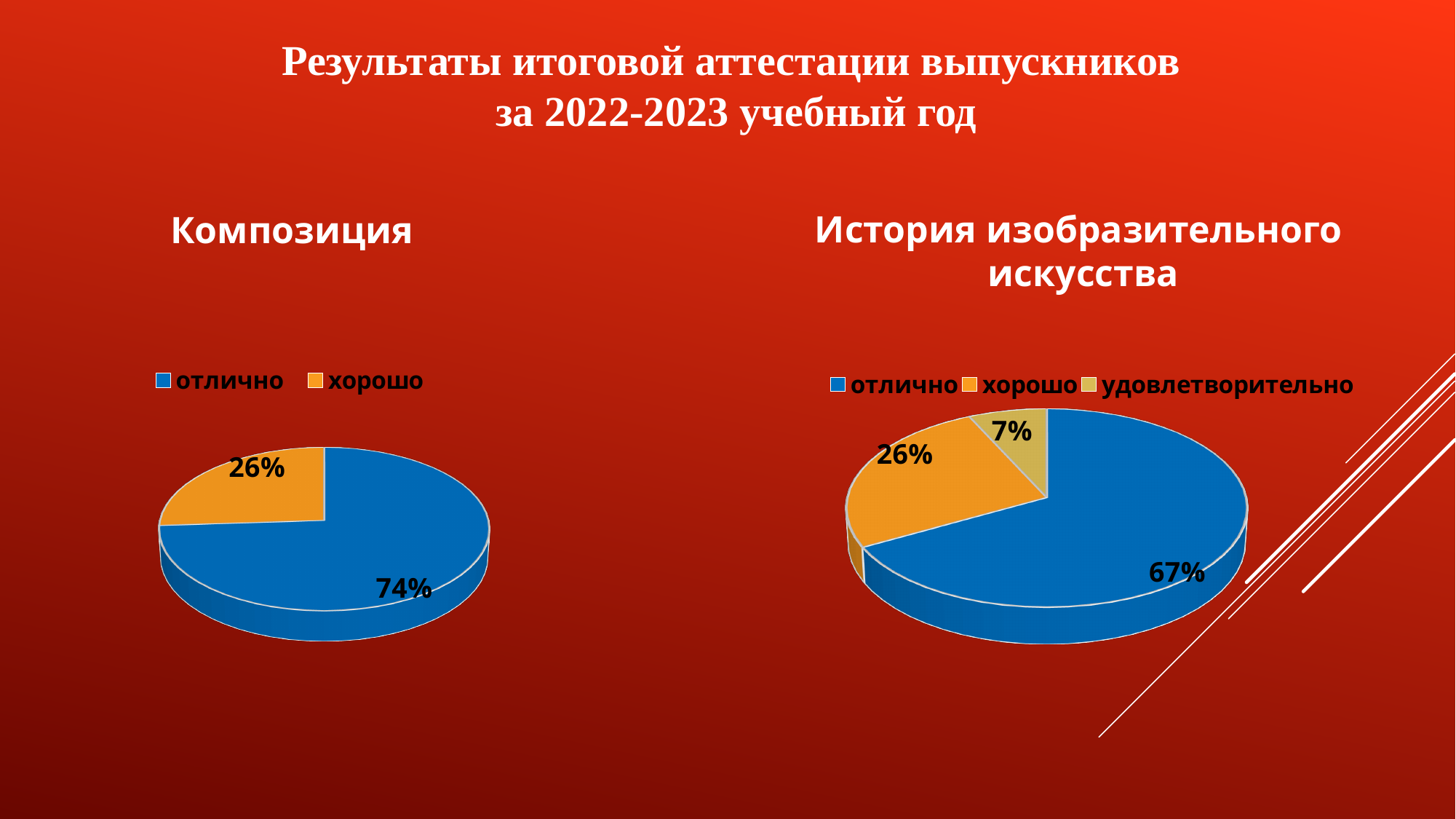
In the "История изобразительного искусства" chart, what is the difference between the "хорошо" and "удовлетворительно" shares? 19% In the "Композиция" chart, which category has the largest slice? отлично In the "История изобразительного искусства" chart, what share is labelled for "удовлетворительно"? 7% In the "История изобразительного искусства" chart, what share is labelled for "отлично"? 67% How many categories does the legend of the "История изобразительного искусства" chart list? 3 In the "Композиция" chart, what share is labelled for "хорошо"? 26% In the "История изобразительного искусства" chart, which category has the smallest slice? удовлетворительно In the "Композиция" chart, what is the difference between the "отлично" and "хорошо" shares? 48% In the "История изобразительного искусства" chart, what share is labelled for "хорошо"? 26% What kind of chart is the "Композиция" chart? Pie chart Which chart has the larger share for "отлично": "Композиция" or "История изобразительного искусства"? Композиция In the "Композиция" chart, what share is labelled for "отлично"? 74%